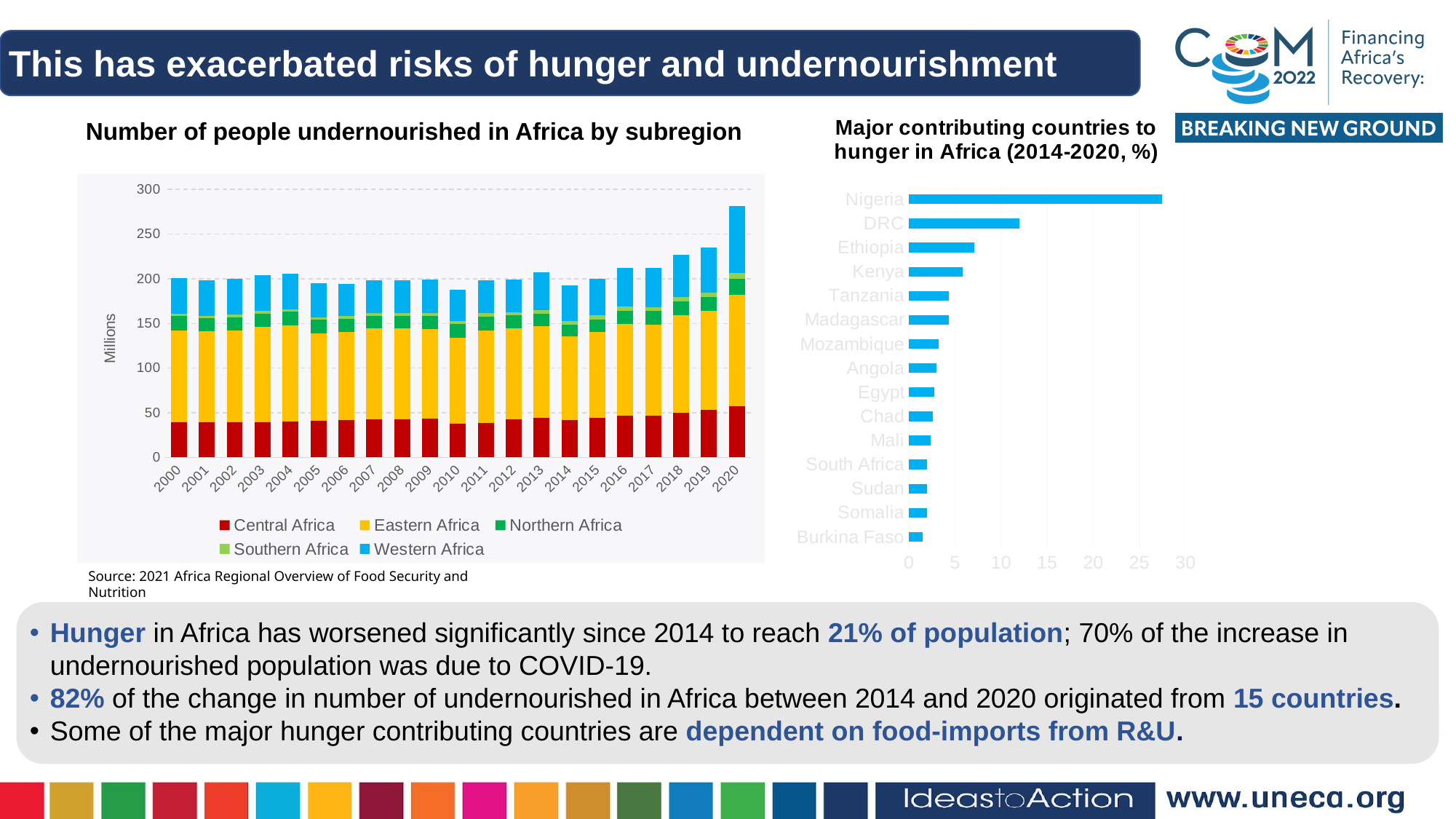
In the 'Major contributing countries to hunger in Africa (2014-2020, %)' chart, is the value for Nigeria greater or less than 25? greater What kind of chart is the 'Number of people undernourished in Africa by subregion' chart? Stacked bar chart In the 'Major contributing countries to hunger in Africa (2014-2020, %)' chart, which country has the lowest value? Burkina Faso In the 'Number of people undernourished in Africa by subregion' chart, is the total for 2020 greater or less than 250 million? greater How many series does the legend of the 'Number of people undernourished in Africa by subregion' chart list? 5 How many years are shown on the x axis of the 'Number of people undernourished in Africa by subregion' chart? 21 In the 'Number of people undernourished in Africa by subregion' chart, do the totals rise or fall from 2014 to 2020? Rise In the 'Number of people undernourished in Africa by subregion' chart, which subregion is shown in yellow? Eastern Africa How many countries are shown in the 'Major contributing countries to hunger in Africa (2014-2020, %)' chart? 15 In the 'Number of people undernourished in Africa by subregion' chart, is the total for 2010 greater or less than 200 million? less In the 'Major contributing countries to hunger in Africa (2014-2020, %)' chart, which country has the highest value? Nigeria In the 'Number of people undernourished in Africa by subregion' chart, which year has the highest total? 2020